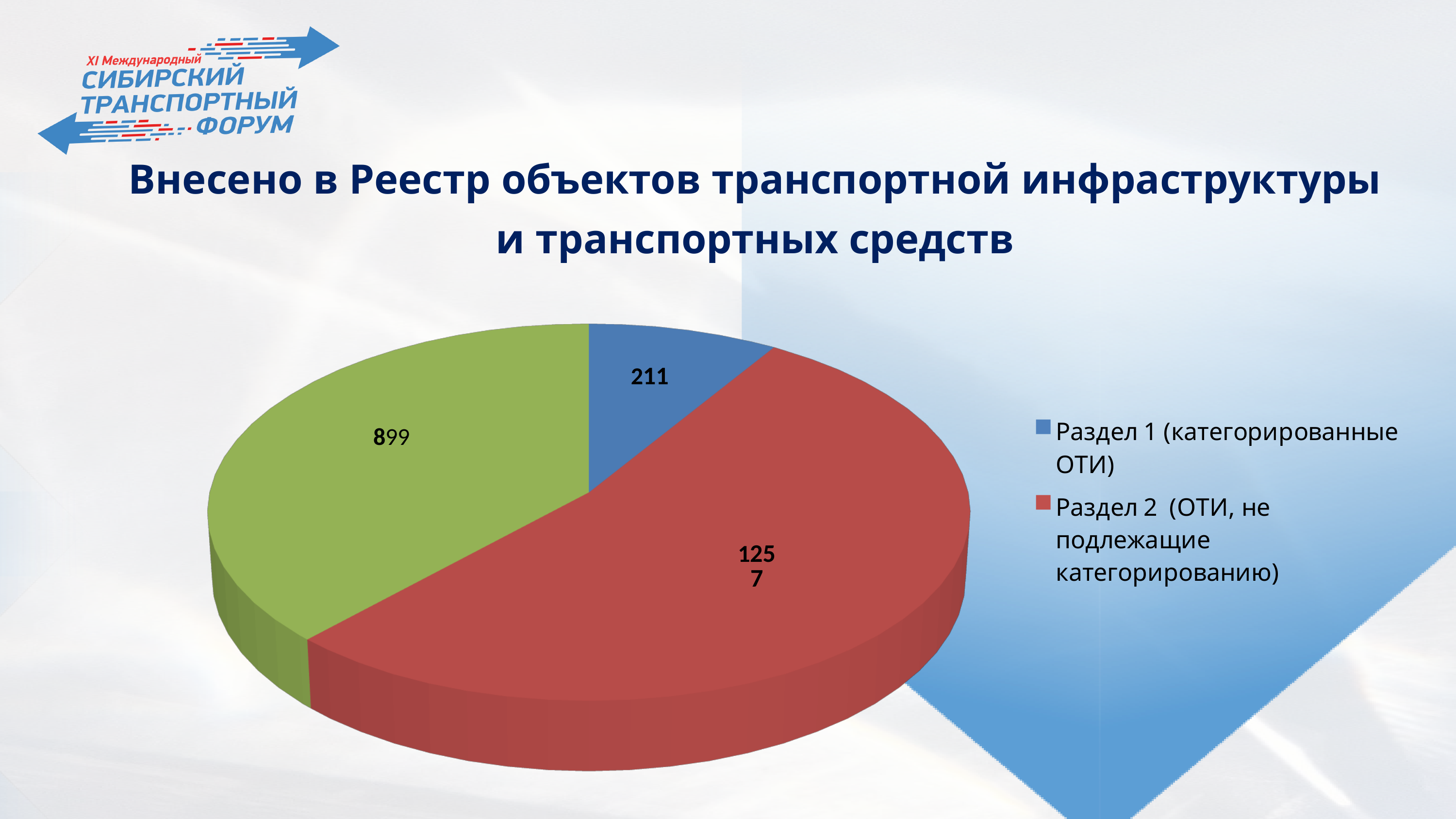
Which slice of the pie chart is the smallest? Раздел 1 (категорированные ОТИ) What kind of chart is shown on the slide? Pie chart What value is shown for Раздел 1 (категорированные ОТИ) in the pie chart? 211 Which is larger: the value for Раздел 1 or the value for Раздел 2? Раздел 2 How many slices does the pie chart have? 3 What is the difference between the value for Раздел 2 (1257) and the value for Раздел 1 (211)? 1046 What value is shown for Раздел 2 (ОТИ, не подлежащие категорированию) in the pie chart? 1257 What value is shown on the green slice of the pie chart? 899 What is the title of the slide containing the pie chart? Внесено в Реестр объектов транспортной инфраструктуры и транспортных средств Which slice of the pie chart is the largest? Раздел 2 (ОТИ, не подлежащие категорированию) How many entries does the legend of the pie chart list? 2 What colour is the slice for Раздел 1 (категорированные ОТИ)? Blue